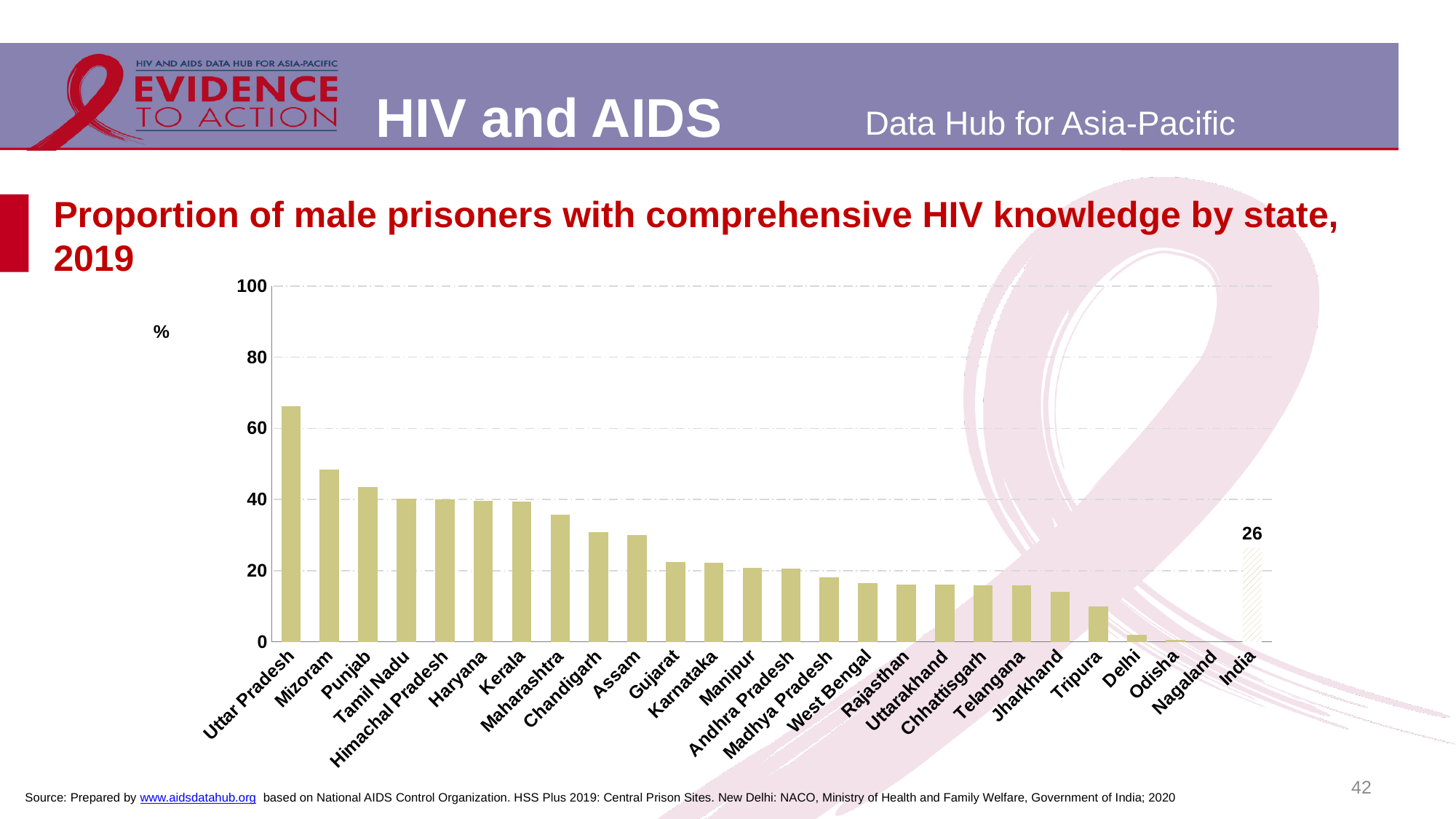
Do the bar values generally rise or fall from left to right along the x axis? Fall Is the value for Uttar Pradesh greater or less than 60? greater What type of chart is shown on the slide? Bar chart Is the value for Tripura greater or less than 20? less Which has a higher value, Punjab or Tripura? Punjab What unit is shown on the y axis of the chart? % Is the value for Mizoram greater or less than 40? greater Which state has the highest proportion of male prisoners with comprehensive HIV knowledge? Uttar Pradesh What is the value shown for India? 26 How many categories are shown on the x axis of the chart? 26 Which has a higher value, Uttar Pradesh or Mizoram? Uttar Pradesh